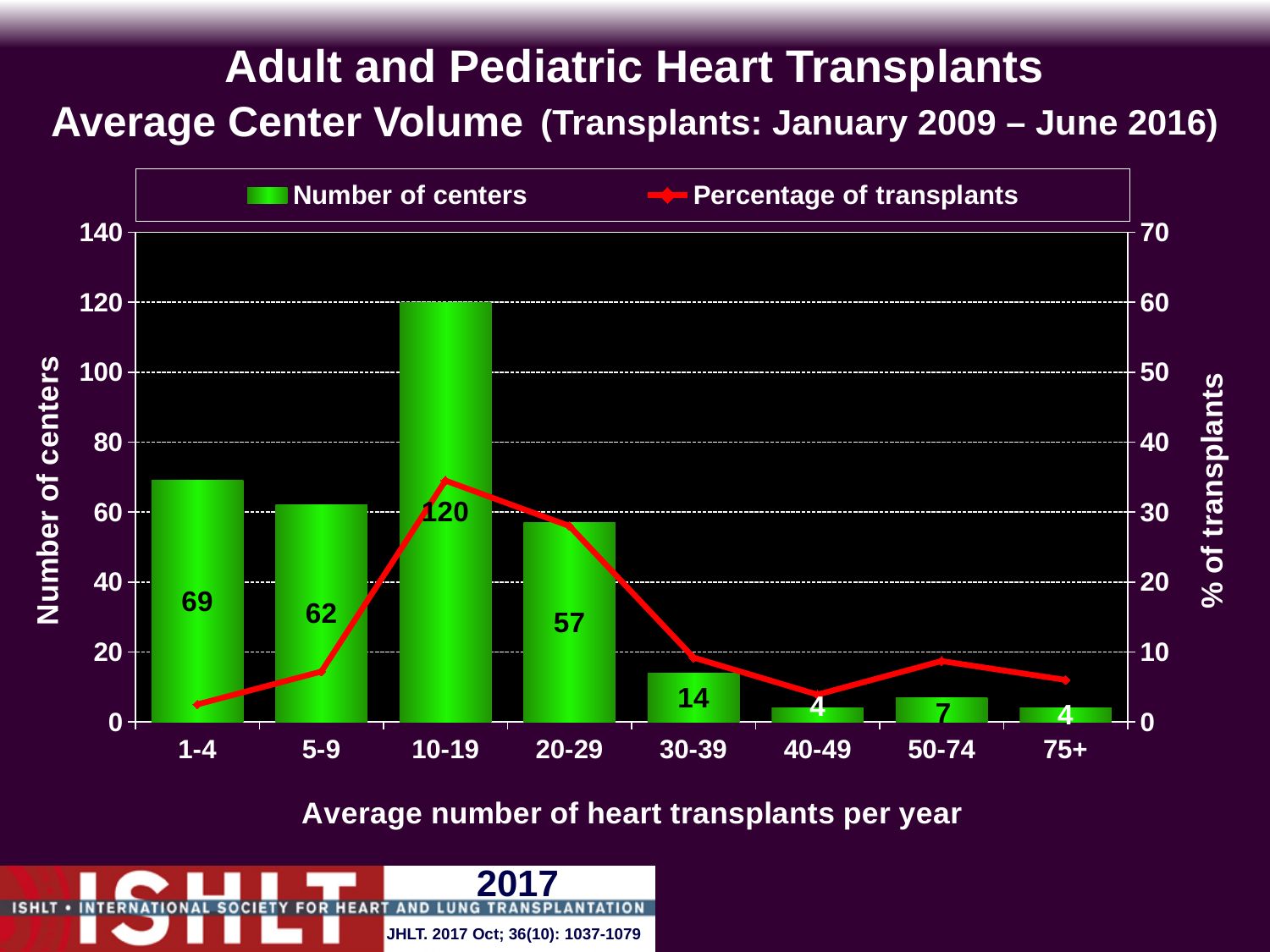
What is the number of centers for the 10-19 category? 120 What is the number of centers for the 30-39 category? 14 Is the percentage of transplants for the 20-29 category greater or less than 20? greater Is the percentage of transplants for the 10-19 category greater or less than 30? greater Is the percentage of transplants for the 1-4 category greater or less than 10? less How many categories are shown on the x axis? 8 How many series does the legend list? 2 Which category has the highest number of centers? 10-19 Which has more centers, the 20-29 category or the 5-9 category? 5-9 What is the label of the left vertical axis? Number of centers What is the x-axis title of the chart? Average number of heart transplants per year What is the difference in number of centers between the 1-4 and 5-9 categories? 7